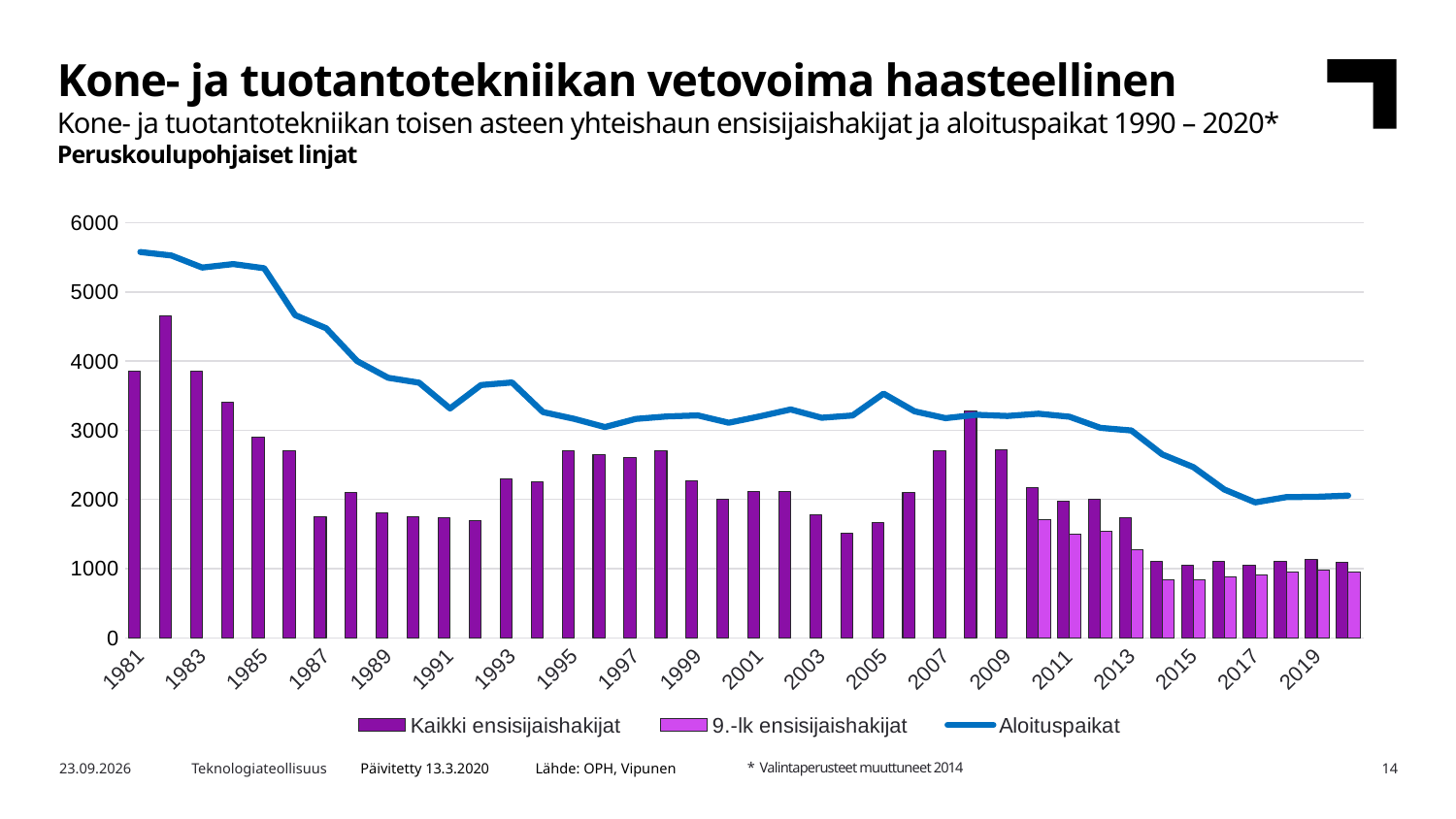
What is the title of the slide? Kone- ja tuotantotekniikan vetovoima haasteellinen Does the Aloituspaikat line generally rise or fall from 1981 to 2020? fall In which year is the Kaikki ensisijaishakijat bar highest? 1982 Which series is drawn as a line rather than bars? Aloituspaikat Is the value of Aloituspaikat in 1981 greater or less than 5000? greater Is the value of Aloituspaikat in 2017 greater or less than 3000? less What kind of chart is shown on the slide? A combined bar and line chart Is the value of Kaikki ensisijaishakijat in 2019 greater or less than 2000? less In 2010, which is larger, Kaikki ensisijaishakijat or 9.-lk ensisijaishakijat? Kaikki ensisijaishakijat Which is larger, Kaikki ensisijaishakijat in 1981 or in 2019? 1981 How many series does the legend list? 3